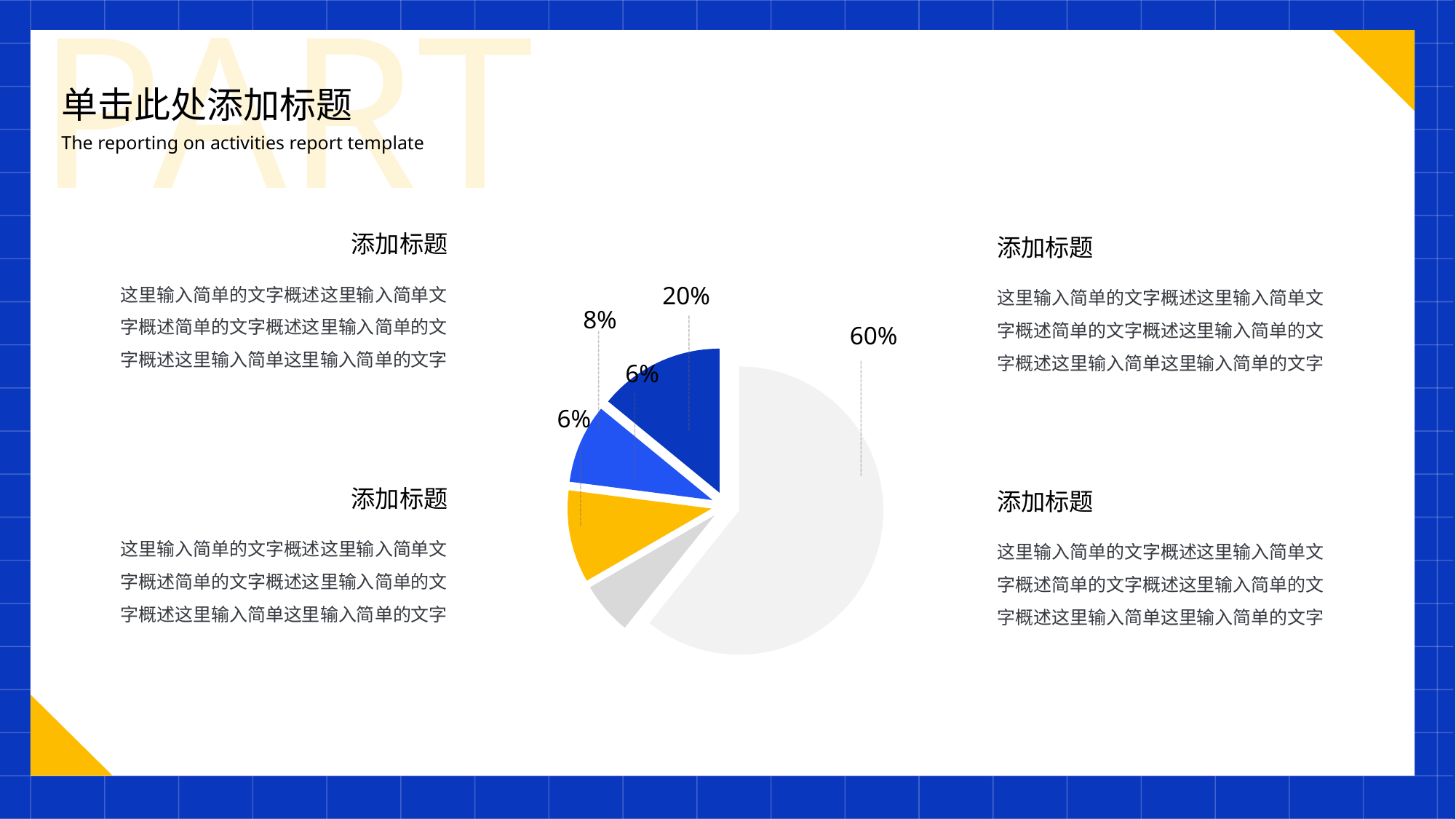
What share of the pie does the largest slice represent? 60% What is the smallest value shown on the pie chart? 6% How many slices on the pie chart are labelled 6%? 2 What is the difference between the 20% slice and the 8% slice? 12 percentage points What kind of chart is shown on the slide? pie chart How many slices does the pie chart have? 5 What is the largest value shown on the pie chart? 60% Does the pie chart have a legend? No What is the difference between the largest slice (60%) and the second-largest slice (20%)? 40 percentage points Which is larger, the 20% slice or the 8% slice? the 20% slice What value is labelled on the dark blue slice of the pie chart? 20% What colour is the largest slice of the pie chart? light gray